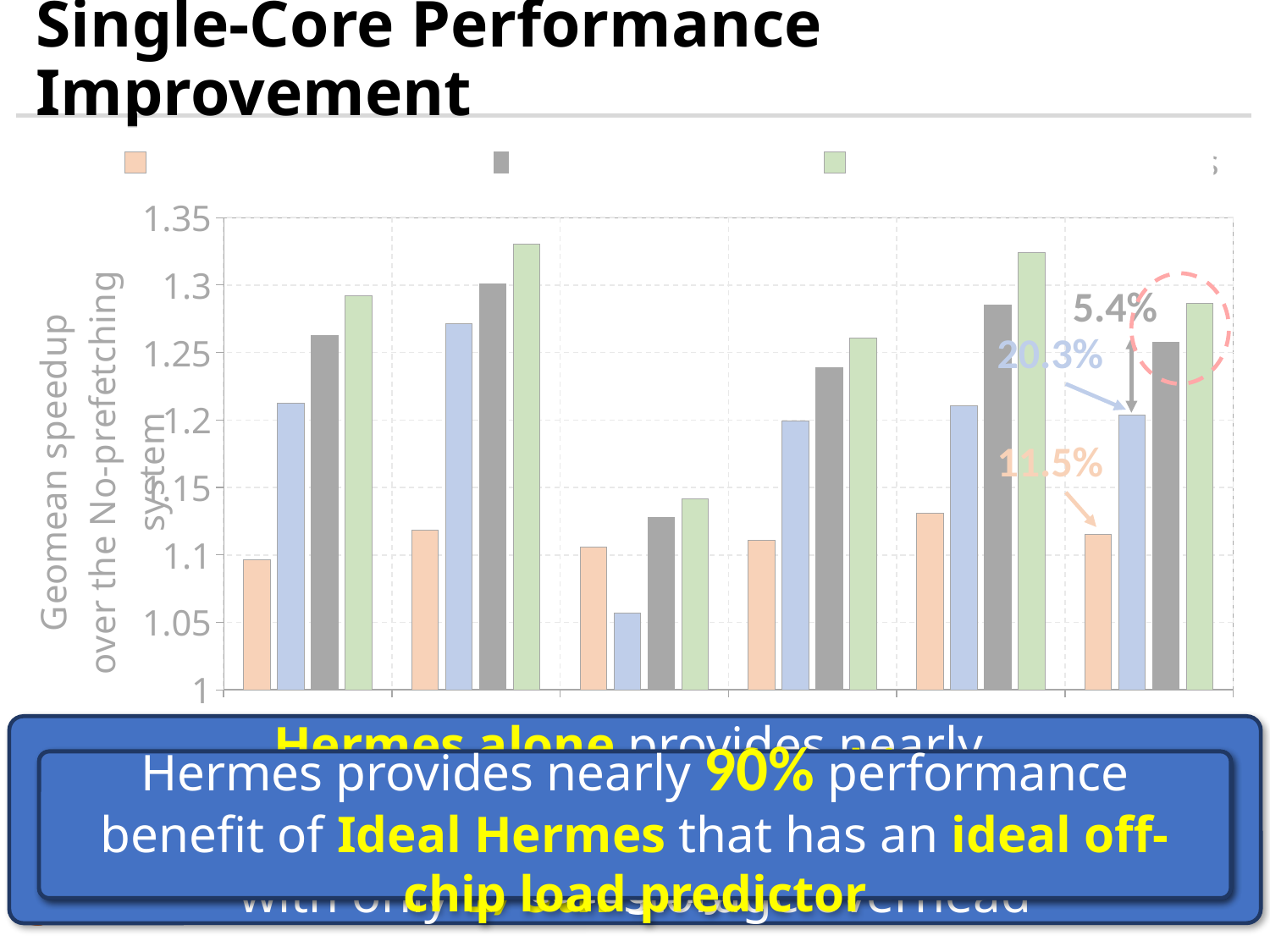
In the third group from the left, is the value of the blue bar greater or less than 1.1? less Which colour bar is the tallest in the leftmost group? green What percentage annotation points to the blue bar in the rightmost group? 20.3% Which colour bar is the lowest in the third group from the left? blue What kind of chart is shown on the slide? bar chart In the fifth group from the left, is the value of the gray bar greater or less than 1.25? greater In the fourth group from the left, is the value of the orange bar greater or less than 1.15? less In the rightmost group, which is taller, the gray bar or the green bar? green What is the label of the y axis? Geomean speedup over the No-prefetching system How many bars are there in each group? 4 How many groups of bars are plotted along the x axis? 6